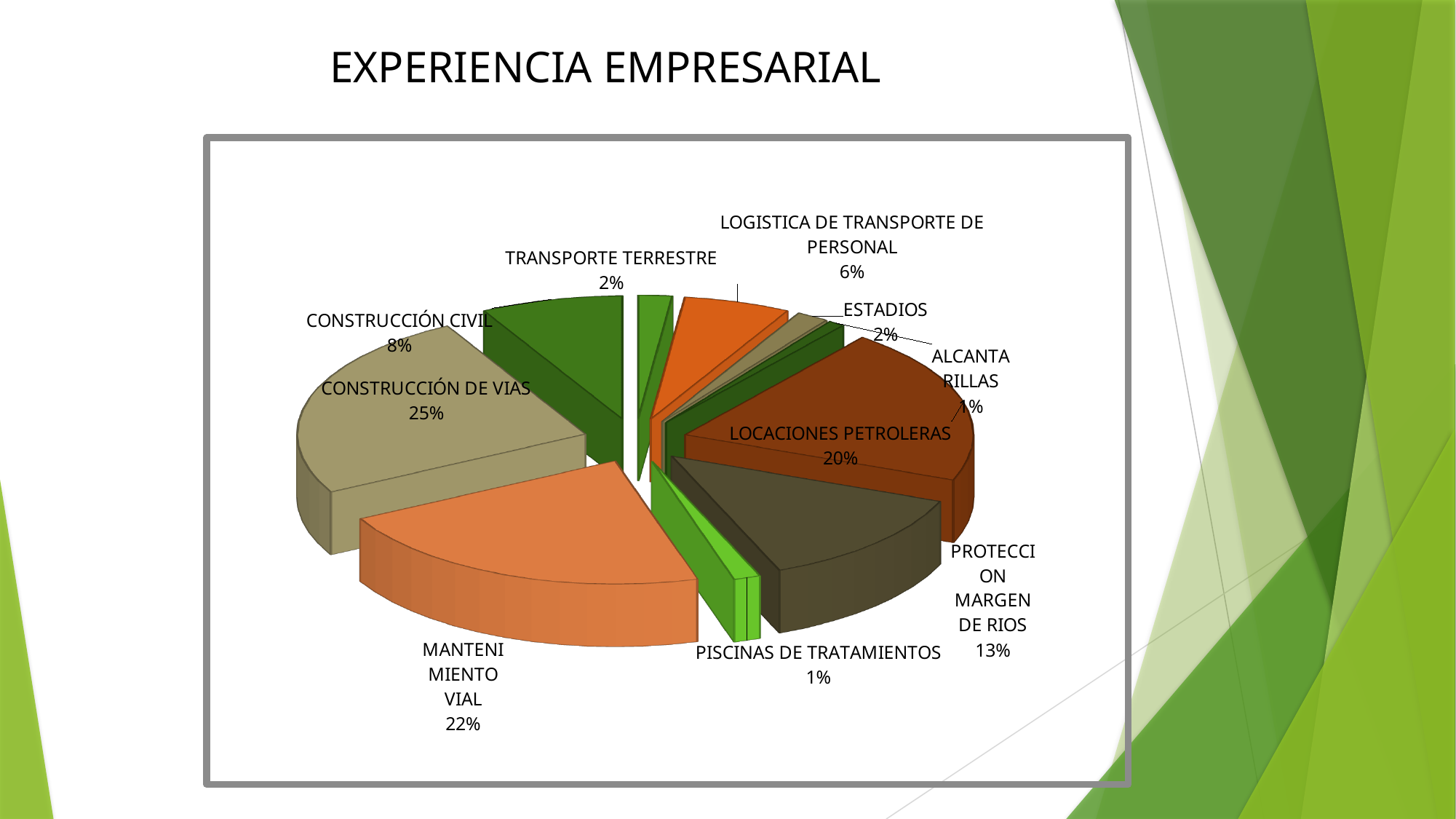
What share of the pie does CONSTRUCCIÓN DE VIAS represent? 25% What is the difference between the shares of CONSTRUCCIÓN CIVIL and TRANSPORTE TERRESTRE? 6% What percentage is shown for LOGISTICA DE TRANSPORTE DE PERSONAL? 6% Which category has the largest share of the pie? CONSTRUCCIÓN DE VIAS What is the title of the slide containing the pie chart? EXPERIENCIA EMPRESARIAL How many categories (slices) does the pie chart have? 10 Which is larger, the share for LOCACIONES PETROLERAS or the share for PROTECCION MARGEN DE RIOS? LOCACIONES PETROLERAS What percentage is shown for MANTENIMIENTO VIAL? 22% What type of chart is shown on the slide? pie chart What percentage is shown for LOCACIONES PETROLERAS? 20% What percentage is shown for PROTECCION MARGEN DE RIOS? 13% What is the difference between the shares of CONSTRUCCIÓN DE VIAS and MANTENIMIENTO VIAL? 3%